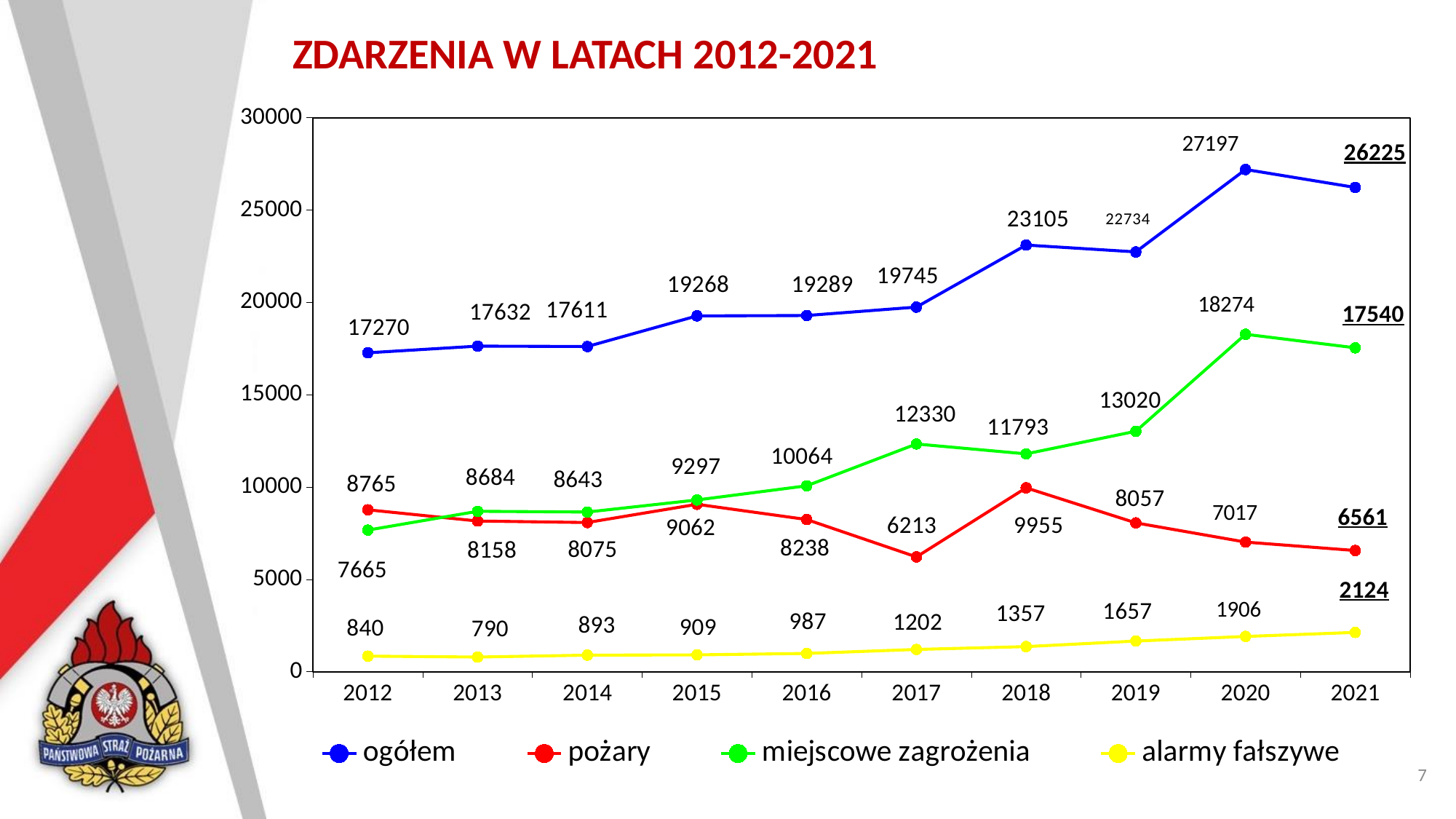
In which year is the pożary series lowest? 2017 What is the value for miejscowe zagrożenia in 2019? 13020 How many series does the legend list? 4 What kind of chart is shown on the slide? line chart In 2013, which is larger: pożary or miejscowe zagrożenia? miejscowe zagrożenia What is the value for pożary in 2017? 6213 What is the value for alarmy fałszywe in 2021? 2124 What is the difference between the miejscowe zagrożenia values in 2020 and 2019? 5254 How many years are shown on the x axis? 10 What is the value for ogółem in 2020? 27197 In which year is the ogółem series highest? 2020 By how much did the ogółem value fall from 2020 to 2021? 972